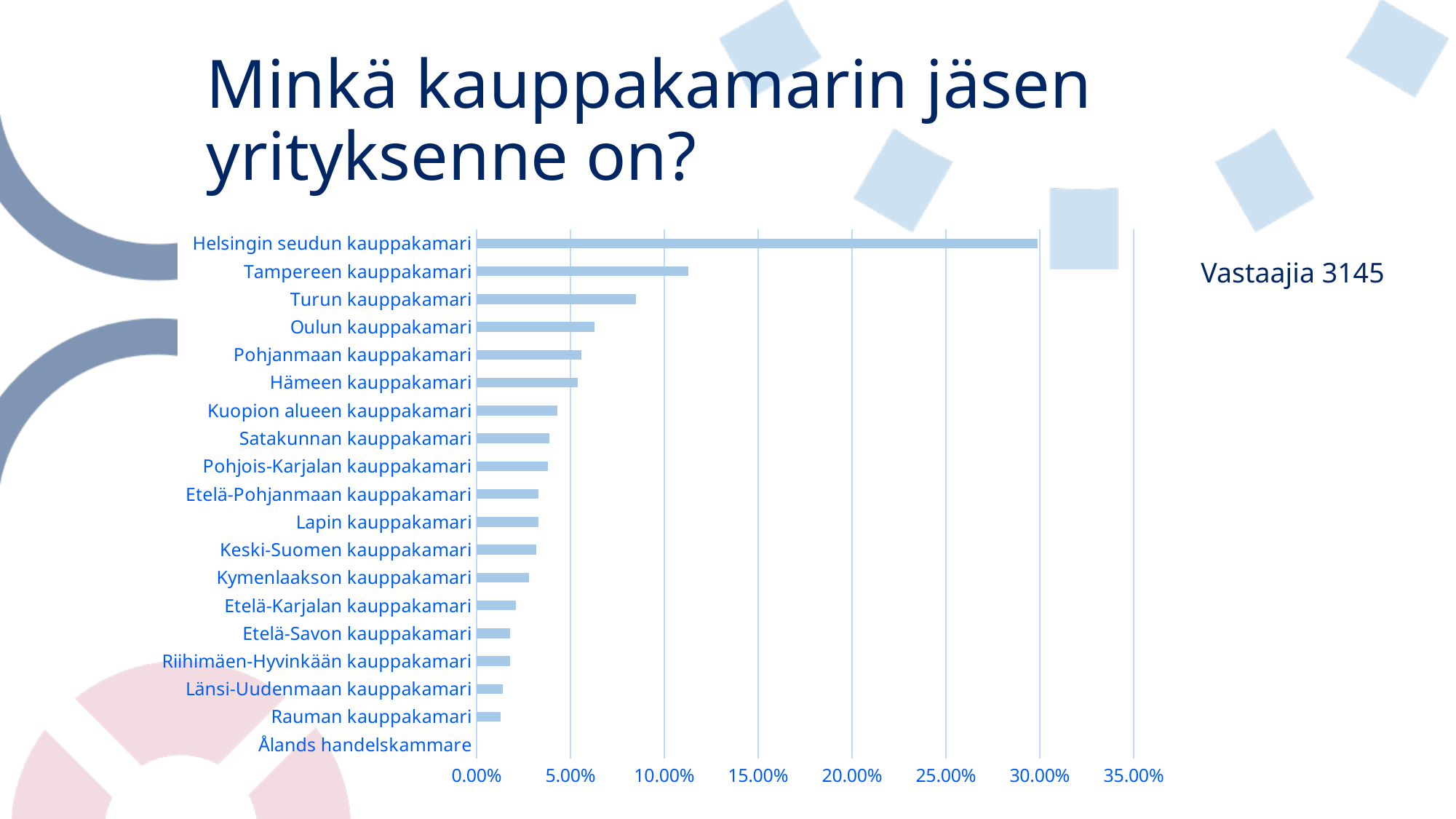
How many categories are listed on the chart's vertical axis? 19 Is the value for Helsingin seudun kauppakamari greater or less than 25.00%? greater Is the value for Tampereen kauppakamari greater or less than 10.00%? greater What kind of chart is shown on the slide? bar chart Which category has the lowest value in the chart? Ålands handelskammare Which chamber of commerce has the highest share of respondents? Helsingin seudun kauppakamari Is the value for Oulun kauppakamari greater or less than 5.00%? greater What is the highest tick label shown on the horizontal axis? 35.00% Do the bar values increase or decrease going from the top category to the bottom category? decrease Which has a larger value, Tampereen kauppakamari or Turun kauppakamari? Tampereen kauppakamari